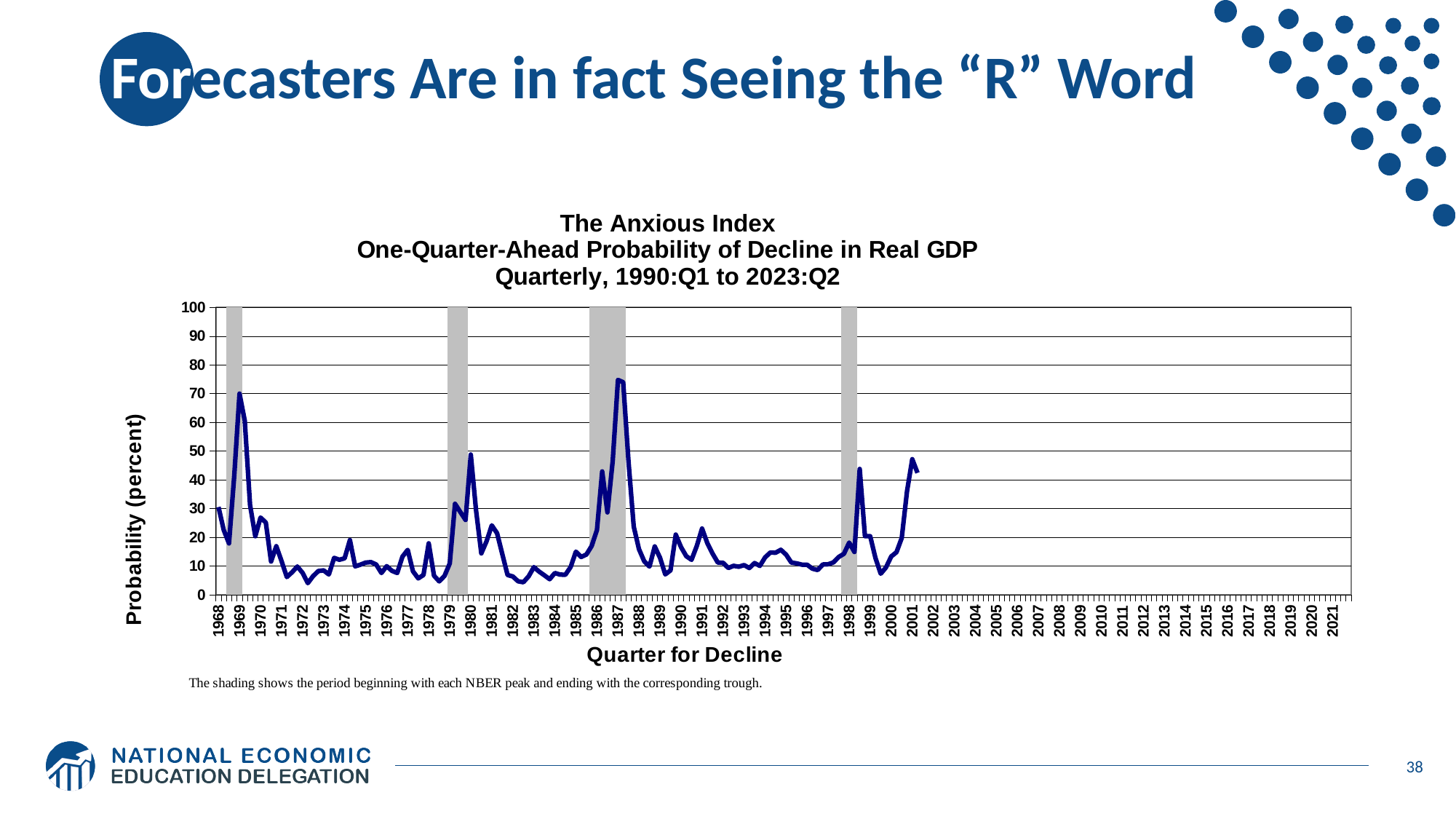
Is the value of the line around 1972 greater or less than 10? less What kind of chart is shown on the slide? line chart Which is higher: the peak of the line around 1987 or the peak around 1980? 1987 What is the title of the y-axis on the chart? Probability (percent) Is the peak value of the line around 1998 greater or less than 30? greater How many data series are plotted on the chart? 1 What is the title of the x-axis on the chart? Quarter for Decline What is the highest value shown on the y-axis? 100 Around which year does the line reach its highest value? 1987 Does the line rise or fall between 2000 and 2001? rise Is the value of the line around 1996 greater or less than 20? less